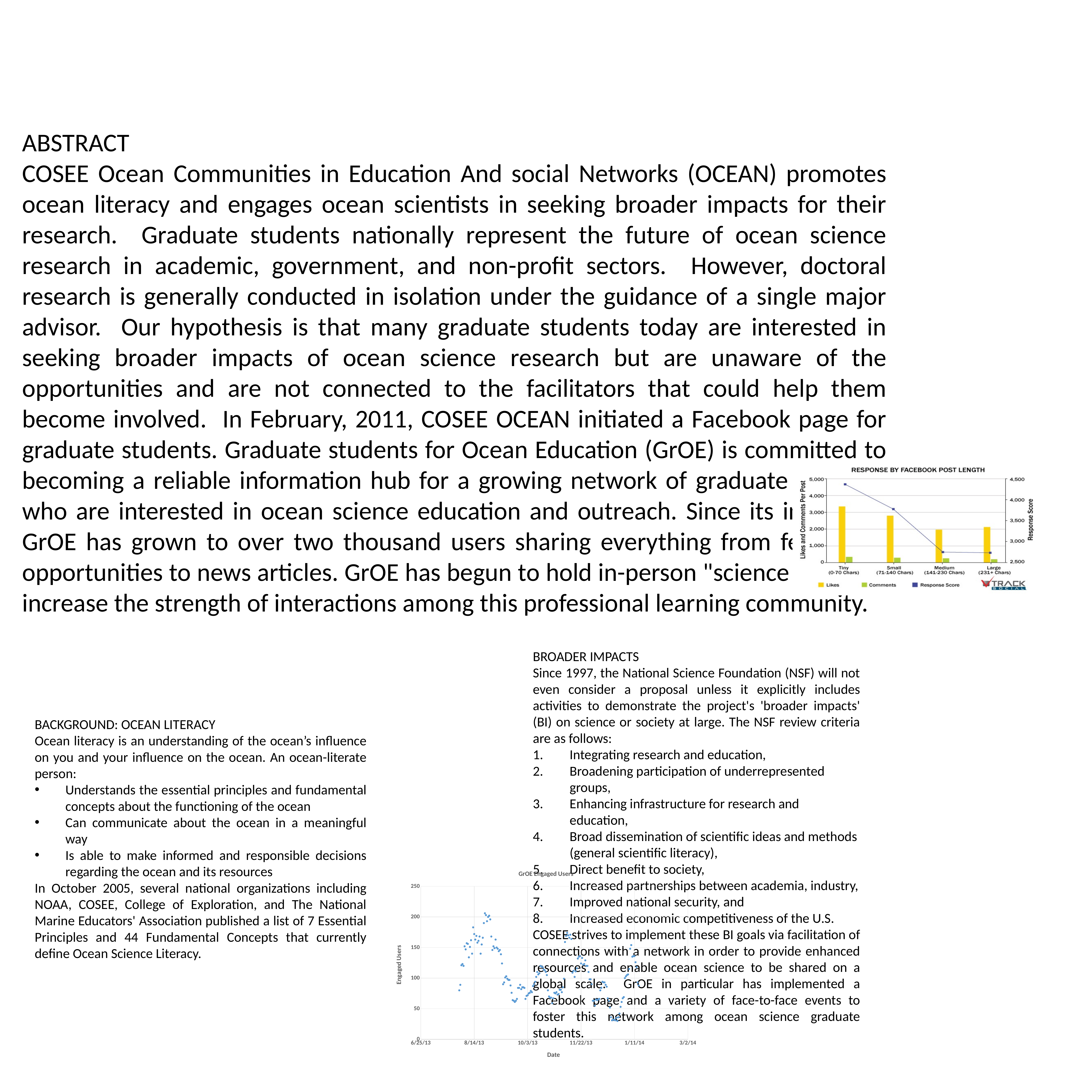
In the 'RESPONSE BY FACEBOOK POST LENGTH' chart, how many post-length categories are shown on the x axis? 4 In the 'RESPONSE BY FACEBOOK POST LENGTH' chart, which post-length category has the highest number of Likes? Tiny (0-70 Chars) In the 'RESPONSE BY FACEBOOK POST LENGTH' chart, does the Response Score rise or fall as post length increases from Tiny to Medium? fall In the 'RESPONSE BY FACEBOOK POST LENGTH' chart, is the Likes value for Medium (141-230 Chars) greater or less than 3,000? less In the 'RESPONSE BY FACEBOOK POST LENGTH' chart, which is larger: Likes for Tiny (0-70 Chars) or Likes for Small (71-140 Chars)? Tiny (0-70 Chars) In the 'RESPONSE BY FACEBOOK POST LENGTH' chart, is the Likes value for Tiny (0-70 Chars) greater or less than 3,000? greater What kind of chart is the 'GrOE Engaged Users' chart at the bottom of the slide? scatter chart In the 'GrOE Engaged Users' chart, what is the label of the y axis? Engaged Users In the 'RESPONSE BY FACEBOOK POST LENGTH' chart, which post-length category has the highest Response Score? Tiny (0-70 Chars) In the 'RESPONSE BY FACEBOOK POST LENGTH' chart, which is larger for Tiny posts: Likes or Comments? Likes In the 'RESPONSE BY FACEBOOK POST LENGTH' chart, what colour are the Likes bars? yellow In the 'RESPONSE BY FACEBOOK POST LENGTH' chart, how many series does the legend list? 3